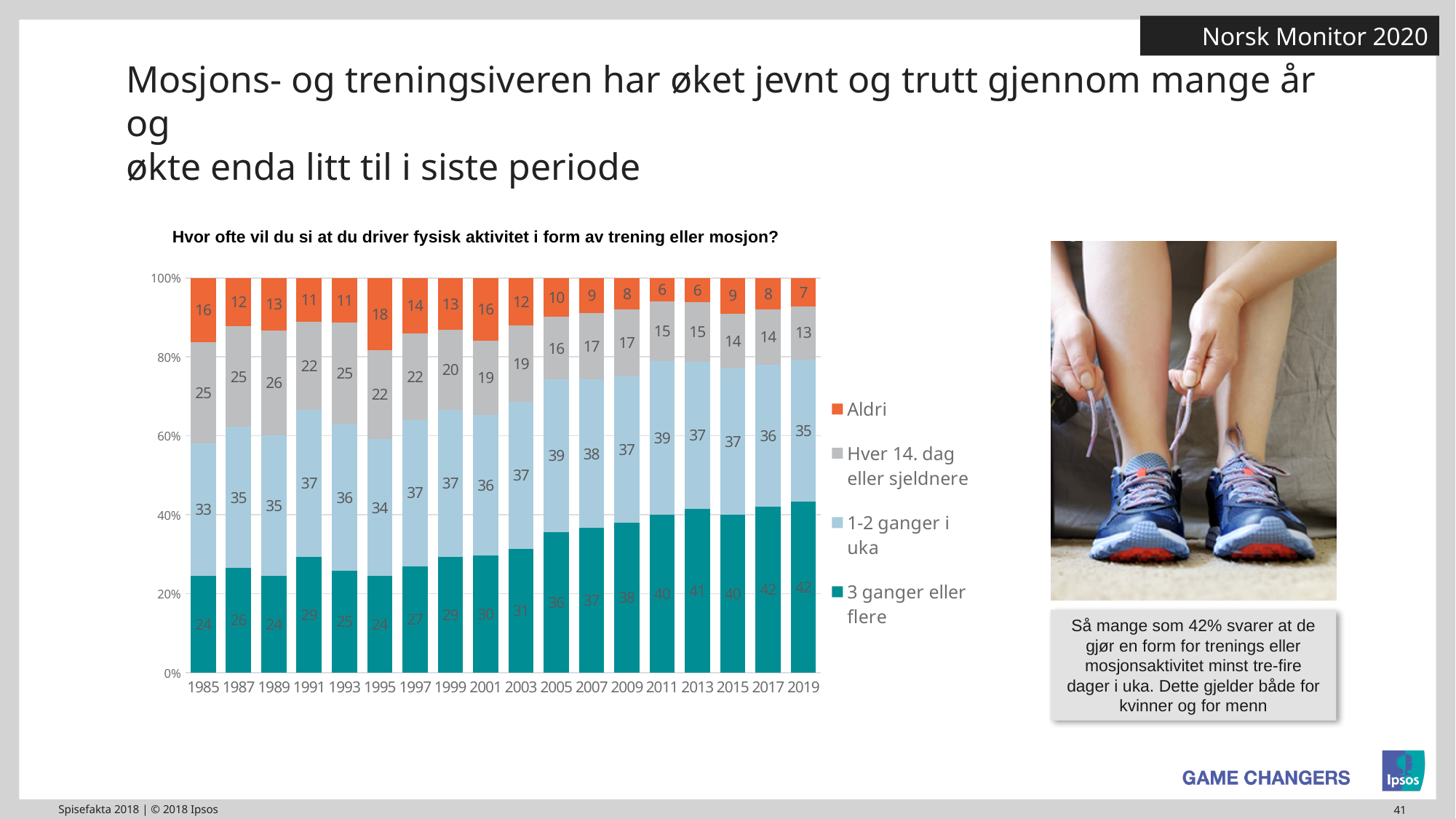
What is the value for 'Hver 14. dag eller sjeldnere' in 1989? 26 What is the value for '3 ganger eller flere' in 2019? 42 What is the value for '1-2 ganger i uka' in 2011? 39 What is the difference between the '3 ganger eller flere' values in 2019 and 1985? 18 What kind of chart is shown on the slide? Stacked bar chart In which year is the '3 ganger eller flere' value lowest? 1985, 1989 and 1995 (all 24) How many years are shown on the x axis? 18 What is the value for 'Aldri' in 1995? 18 How many series does the legend list? 4 In which year is the 'Aldri' value highest? 1995 Which is larger, the 'Hver 14. dag eller sjeldnere' value in 1985 or in 2019? 1985 Does the '3 ganger eller flere' series generally rise or fall from 1985 to 2019? Rise